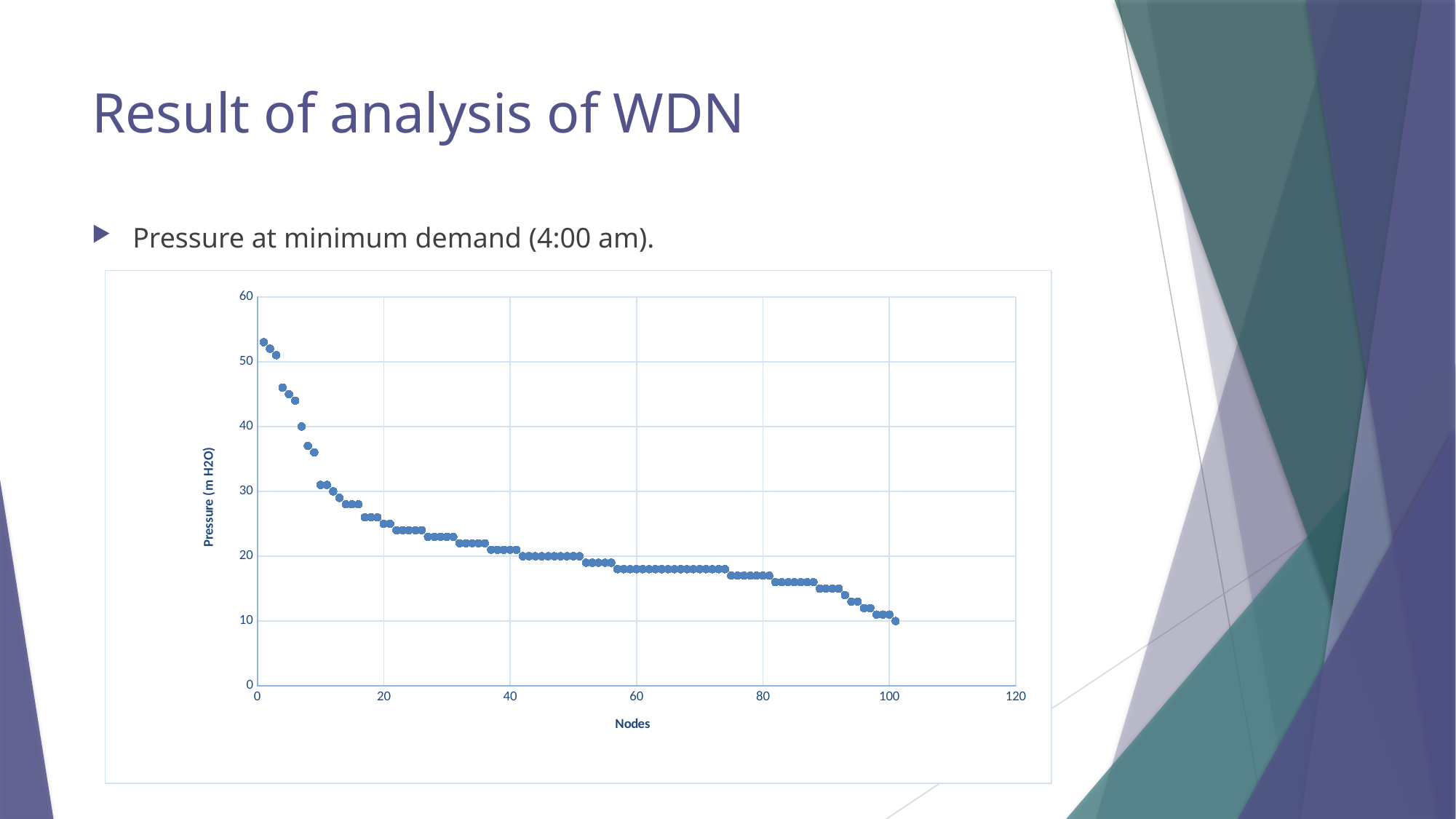
Is the pressure value for node 40 greater or less than 30? less What is the label of the x axis? Nodes What is the label of the y axis? Pressure (m H2O) Do the pressure values rise or fall as the node number increases along the x axis? fall Is the pressure value for node 80 greater or less than 20? less Is the pressure value for node 20 greater or less than 20? greater Which has the higher pressure value, node 1 or node 100? node 1 What kind of chart is shown on the slide? scatter chart